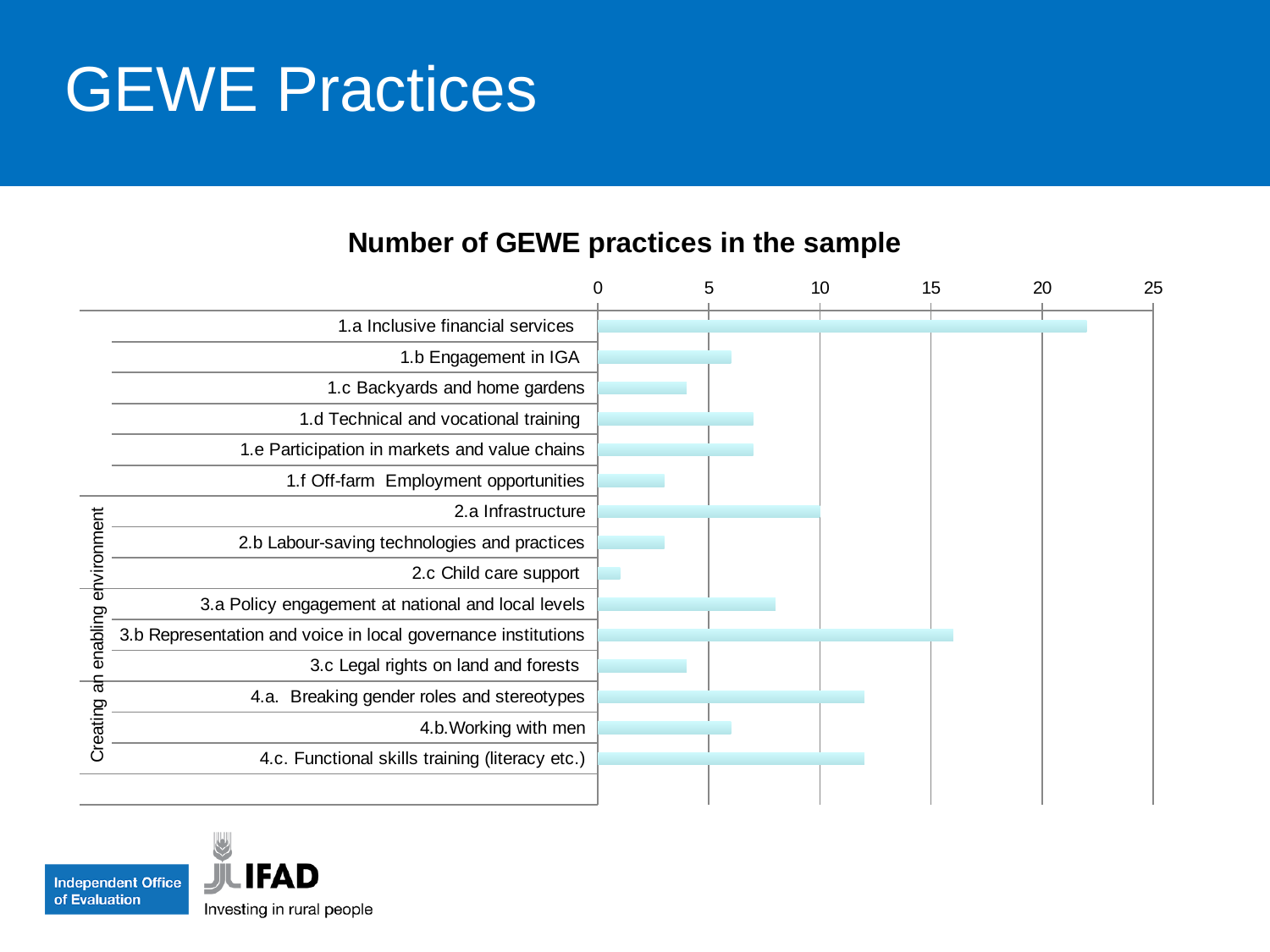
What is the highest value shown on the horizontal axis of the chart? 25 Which has a larger value: 3.b Representation and voice in local governance institutions or 4.a Breaking gender roles and stereotypes? 3.b Representation and voice in local governance institutions Is the value for 3.b Representation and voice in local governance institutions greater or less than 15? greater Is the value for 2.c Child care support greater or less than 5? less What is the title of the chart? Number of GEWE practices in the sample Is the value for 4.a Breaking gender roles and stereotypes greater or less than 10? greater How many GEWE practice categories are plotted in the chart? 15 Which GEWE practice has the lowest number in the sample? 2.c Child care support What kind of chart is shown on the slide? bar chart Which GEWE practice has the highest number in the sample? 1.a Inclusive financial services